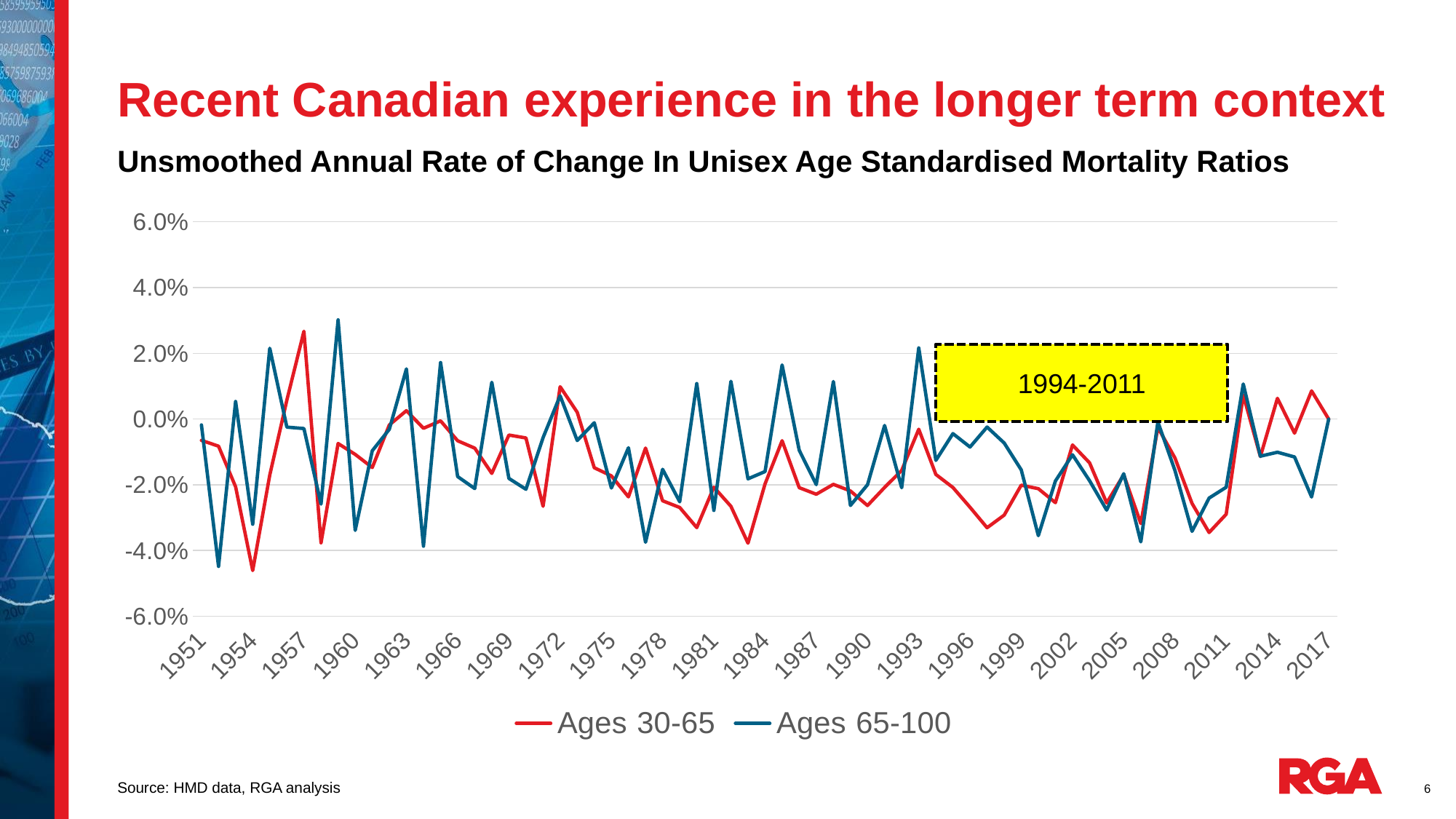
In which year does the Ages 30-65 series reach its lowest value? 1954 In 1959, which series has the higher value, Ages 30-65 or Ages 65-100? Ages 65-100 Is the value for Ages 30-65 in 1955 greater or less than -4.0%? greater In which year does the Ages 65-100 series reach its highest value? 1959 Is the value for Ages 65-100 in 1959 greater or less than 2.0%? greater What period is highlighted by the yellow box on the chart? 1994-2011 What are the two series named in the legend? Ages 30-65 and Ages 65-100 Is the value for Ages 65-100 in 1977 greater or less than -2.0%? less What kind of chart is shown on the slide? Line chart How many series does the legend list? 2 In which year does the Ages 30-65 series reach its highest value? 1957